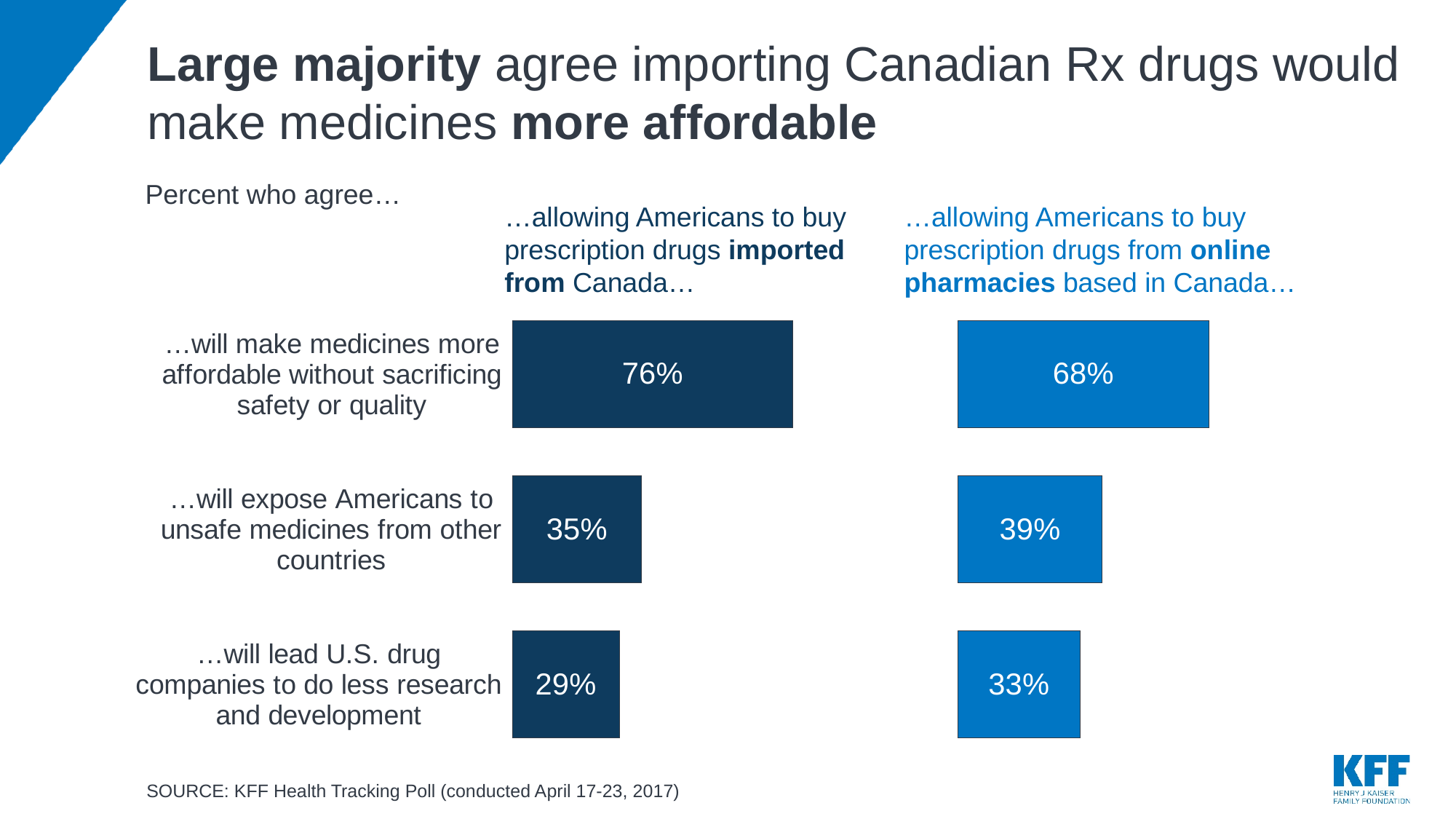
What percent agree that allowing Americans to buy prescription drugs imported from Canada will make medicines more affordable without sacrificing safety or quality? 76% Which statement has the lowest percent agreeing for drugs from online pharmacies based in Canada? …will lead U.S. drug companies to do less research and development Which is larger: the percent agreeing that imported drugs will lead to less research and development, or the percent agreeing that online pharmacy drugs will lead to less research and development? Online pharmacies based in Canada (33%) How many statements are shown in the chart? 3 What percent agree that allowing Americans to buy prescription drugs imported from Canada will expose Americans to unsafe medicines from other countries? 35% What percent agree that allowing Americans to buy prescription drugs from online pharmacies based in Canada will make medicines more affordable without sacrificing safety or quality? 68% What percent agree that allowing Americans to buy prescription drugs from online pharmacies based in Canada will lead U.S. drug companies to do less research and development? 33% What is the difference between the percent agreeing that imported drugs will make medicines more affordable and the percent agreeing that online pharmacy drugs will make medicines more affordable? 8 percentage points Which statement has the highest percent agreeing for drugs imported from Canada? …will make medicines more affordable without sacrificing safety or quality How many series (policy scenarios) does the chart compare? 2 What kind of chart is shown on the slide? Bar chart What is the difference between the percent agreeing that online pharmacy drugs will expose Americans to unsafe medicines and the percent agreeing that imported drugs will do so? 4 percentage points